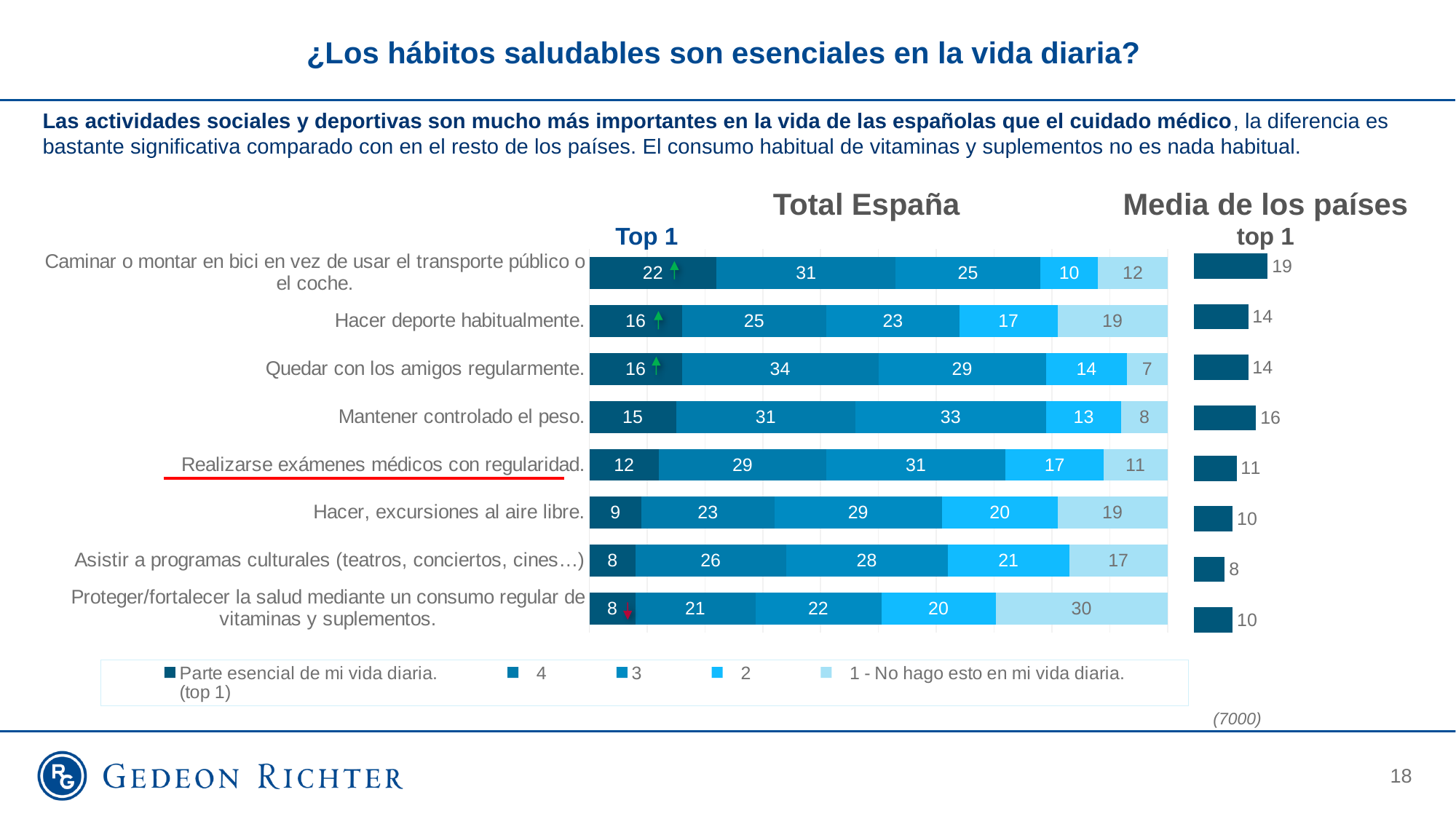
Which is larger: the 'Media de los países top 1' value for 'Mantener controlado el peso' or for 'Hacer deporte habitualmente'? Mantener controlado el peso In the 'Total España' chart, what is the '3' value for 'Mantener controlado el peso'? 33 How many categories are shown in the 'Total España' chart? 8 In the 'Total España' chart, which category has the highest 'top 1' value? Caminar o montar en bici en vez de usar el transporte público o el coche. In the 'Total España' chart, what is the total of the stacked bar for 'Quedar con los amigos regularmente'? 100 In the 'Total España' chart, what is the '1 - No hago esto en mi vida diaria' value for 'Proteger/fortalecer la salud mediante un consumo regular de vitaminas y suplementos'? 30 In the 'Total España' chart, what is the difference between the 'top 1' value for 'Caminar o montar en bici' and the 'top 1' value for 'Realizarse exámenes médicos con regularidad'? 10 In the 'Total España' chart, what is the 'Parte esencial de mi vida diaria (top 1)' value for 'Caminar o montar en bici en vez de usar el transporte público o el coche'? 22 In the 'Media de los países top 1' chart, which category has the lowest value? Asistir a programas culturales (teatros, conciertos, cines…) In the 'Media de los países top 1' chart, what is the value for 'Realizarse exámenes médicos con regularidad'? 11 What kind of chart is the 'Total España' chart? Stacked bar chart How many series does the legend of the 'Total España' chart list? 5